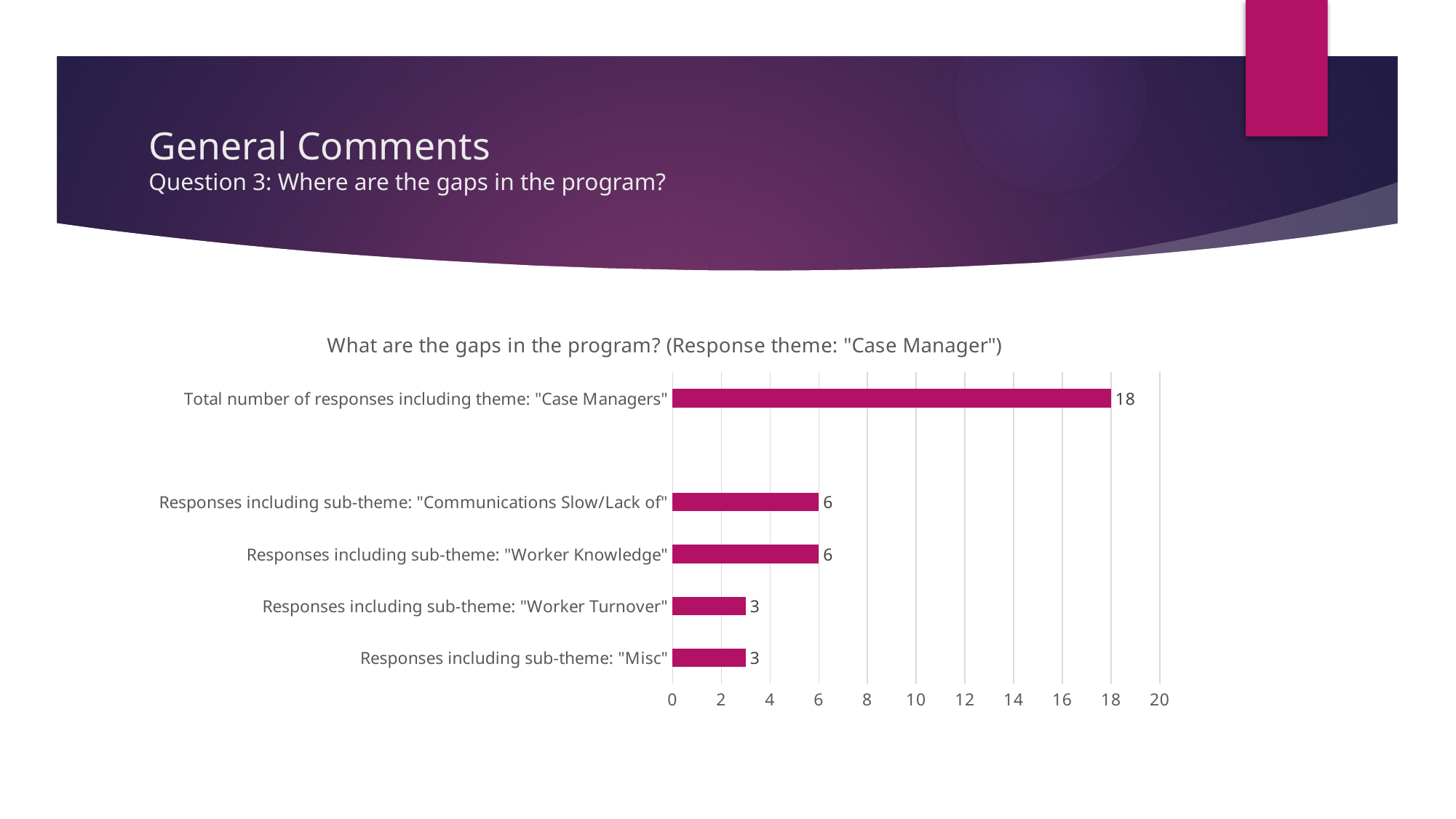
Which category has the highest value? Total number of responses including theme: "Case Managers" What is the value for "Total number of responses including theme: "Case Managers""? 18 What is the title of the chart? What are the gaps in the program? (Response theme: "Case Manager") What is the value for "Responses including sub-theme: "Worker Knowledge""? 6 What is the difference between the value for "Responses including sub-theme: "Communications Slow/Lack of"" and the value for "Responses including sub-theme: "Worker Turnover""? 3 How many categories are shown in the chart? 5 What is the value for "Responses including sub-theme: "Misc""? 3 What is the value for "Responses including sub-theme: "Worker Turnover""? 3 What is the difference between the value for "Total number of responses including theme: "Case Managers"" and the value for "Responses including sub-theme: "Worker Knowledge""? 12 What kind of chart is shown on the slide? Bar chart Which is larger, the value for "Responses including sub-theme: "Worker Knowledge"" or the value for "Responses including sub-theme: "Misc""? Responses including sub-theme: "Worker Knowledge" What is the value for "Responses including sub-theme: "Communications Slow/Lack of""? 6